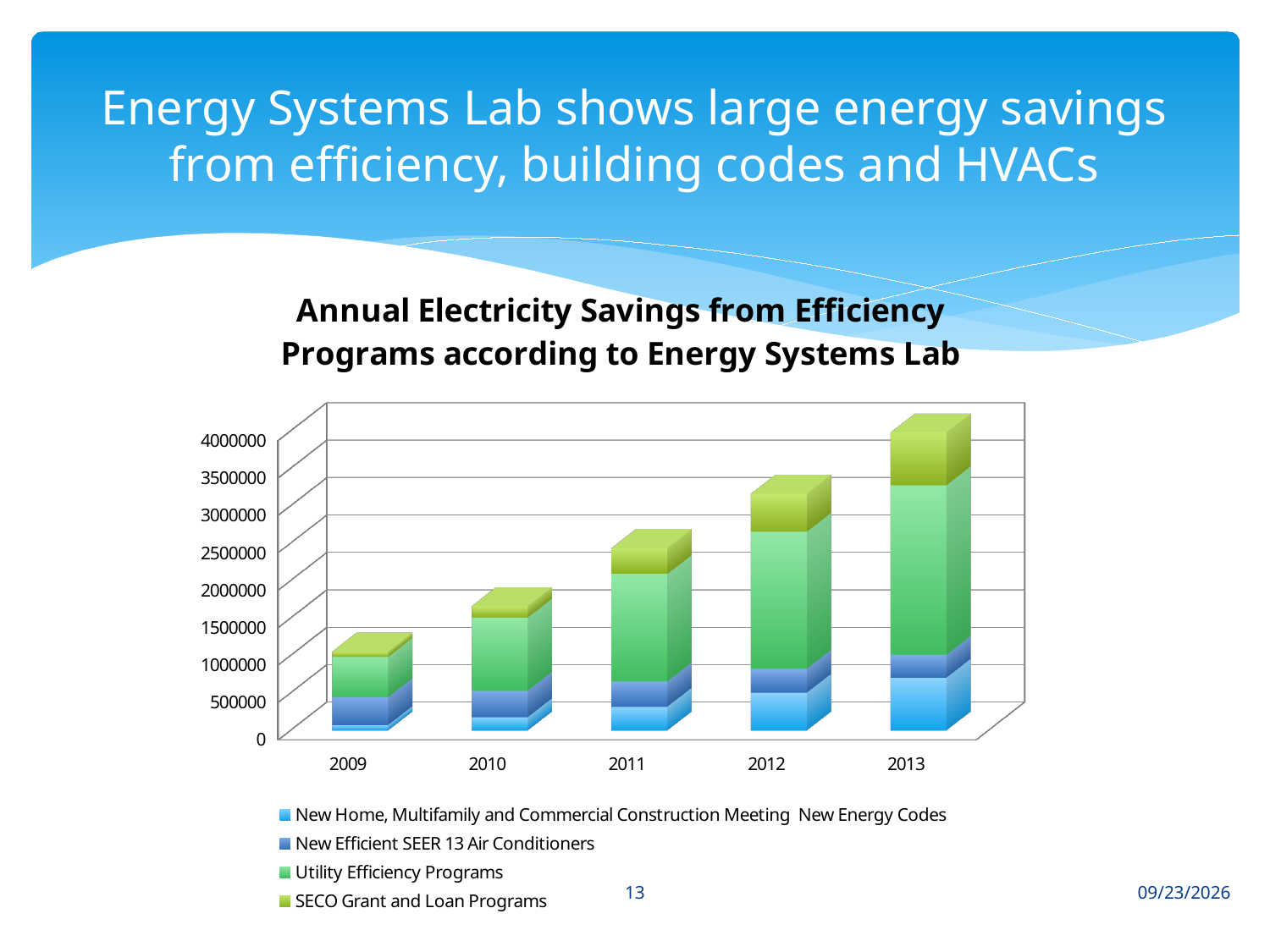
Which year has the highest total annual electricity savings? 2013 Is the total value for 2012 greater or less than 2500000? greater Is the total value for 2009 greater or less than 1500000? less Do the total annual electricity savings rise or fall from 2009 to 2013? Rise How many series does the chart's legend list? 4 Which year has the lowest total annual electricity savings? 2009 Which is larger, the total for 2011 or the total for 2012? 2012 What kind of chart is shown on the slide? Stacked bar chart How many years are shown on the x axis of the chart? 5 What is the title of the chart? Annual Electricity Savings from Efficiency Programs according to Energy Systems Lab Is the total value for 2010 greater or less than 2000000? less